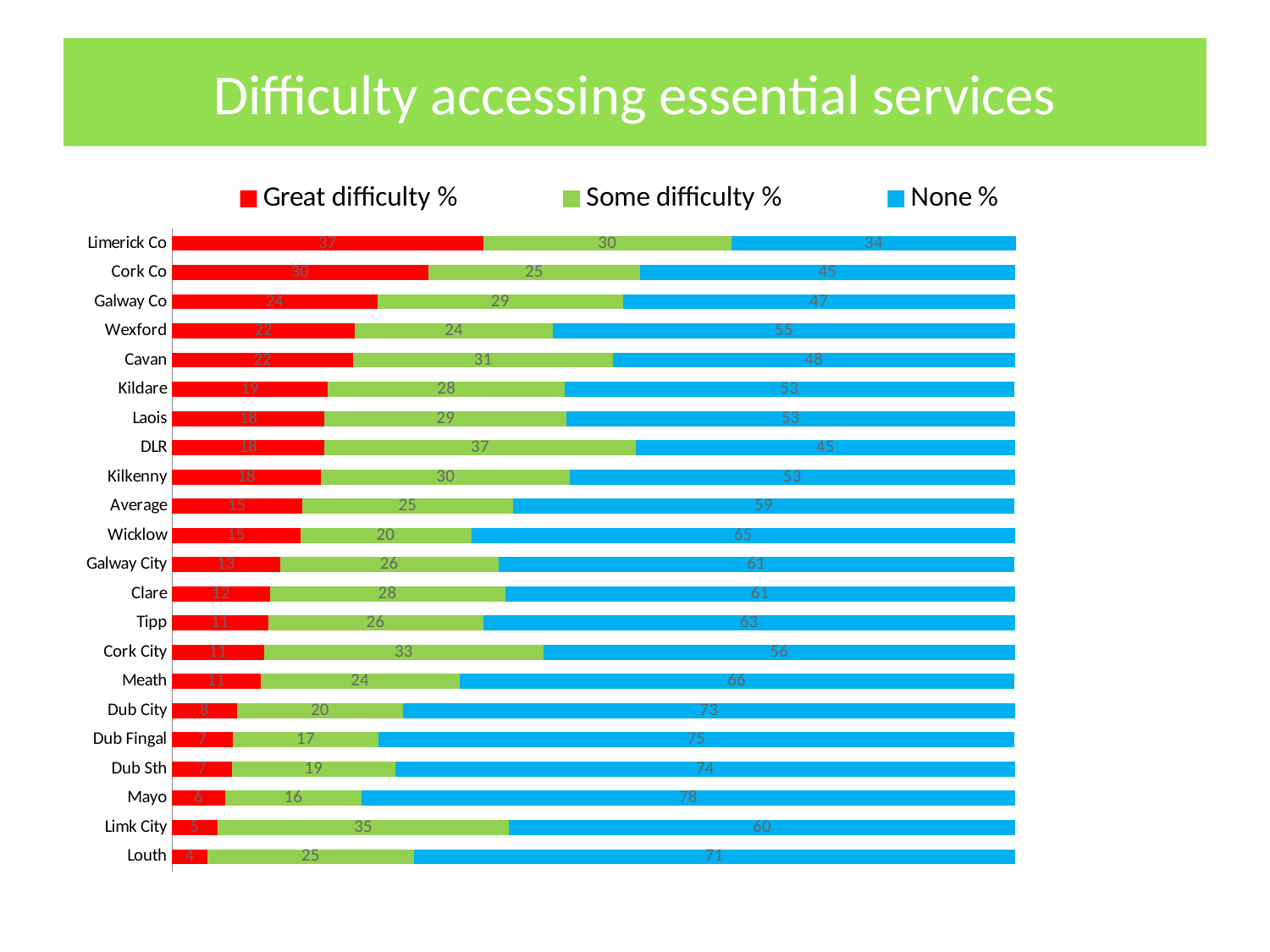
What is the None % value for Mayo? 78 What is the difference between the None % values for Mayo and Limerick Co? 44 What type of chart is shown on the slide? Stacked bar chart What is the Some difficulty % value for DLR? 37 Which is larger, the Some difficulty % value for Limk City or for Wicklow? Limk City How many series does the legend list? 3 Which category has the lowest Great difficulty % value? Louth What is the Great difficulty % value for Limerick Co? 37 What is the total of the stacked bar for Kildare? 100 Which category has the highest None % value? Mayo How many categories are plotted on the chart? 22 Which category has the highest Great difficulty % value? Limerick Co